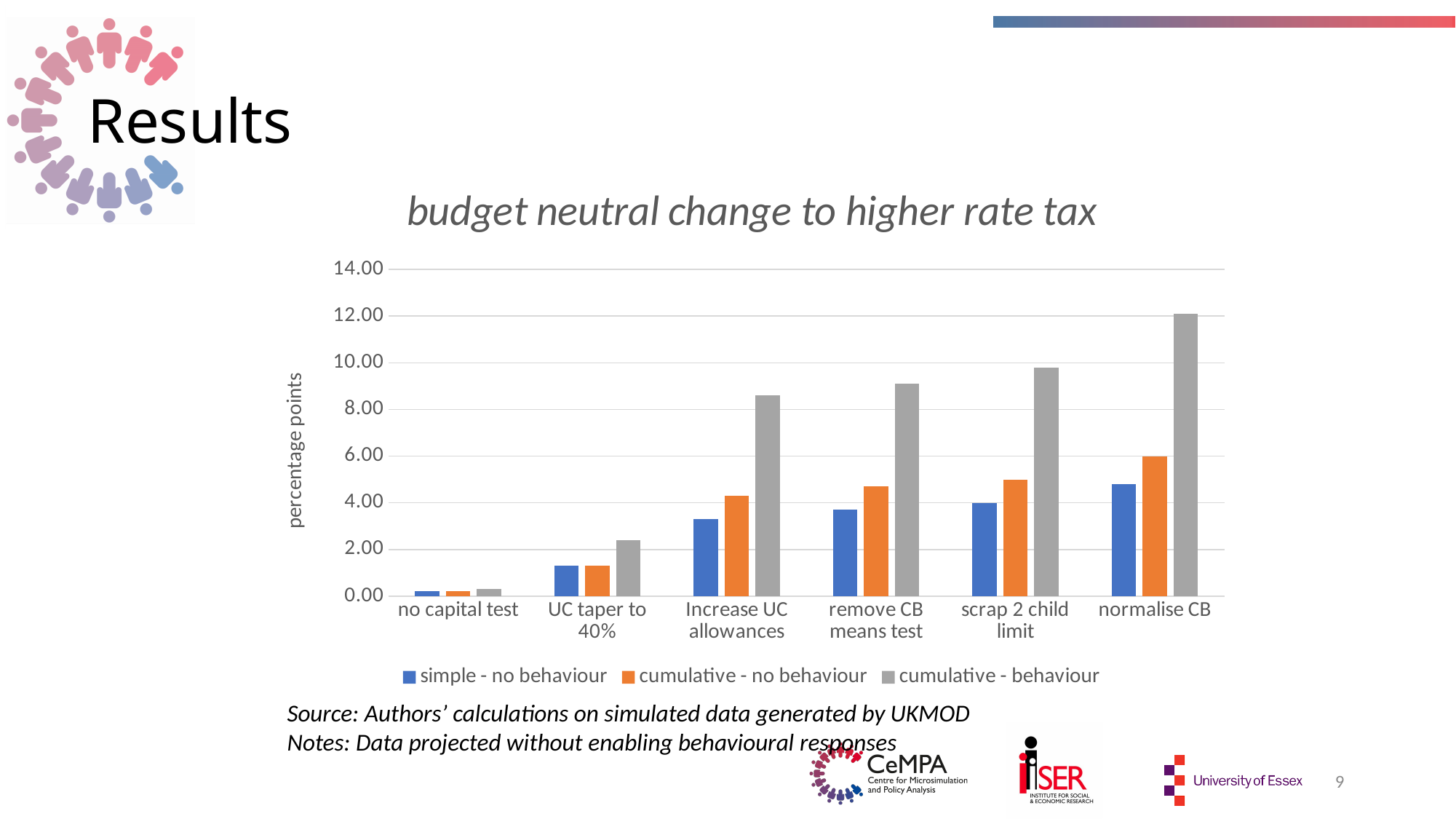
What is the title of the chart? budget neutral change to higher rate tax How many series does the legend list? 3 How many categories are shown on the x axis? 6 Which category has the highest value for the 'cumulative - behaviour' series? normalise CB Which is larger: the 'cumulative - behaviour' value for Increase UC allowances or for normalise CB? normalise CB Is the 'cumulative - behaviour' value for UC taper to 40% greater or less than 2.00? greater Is the 'cumulative - behaviour' value for Increase UC allowances greater or less than 8.00? greater Is the 'cumulative - behaviour' value for normalise CB greater or less than 10.00? greater Do the 'cumulative - behaviour' values rise or fall moving left to right along the x axis? rise Which category has the lowest value for the 'simple - no behaviour' series? no capital test What kind of chart is shown on the slide? bar chart